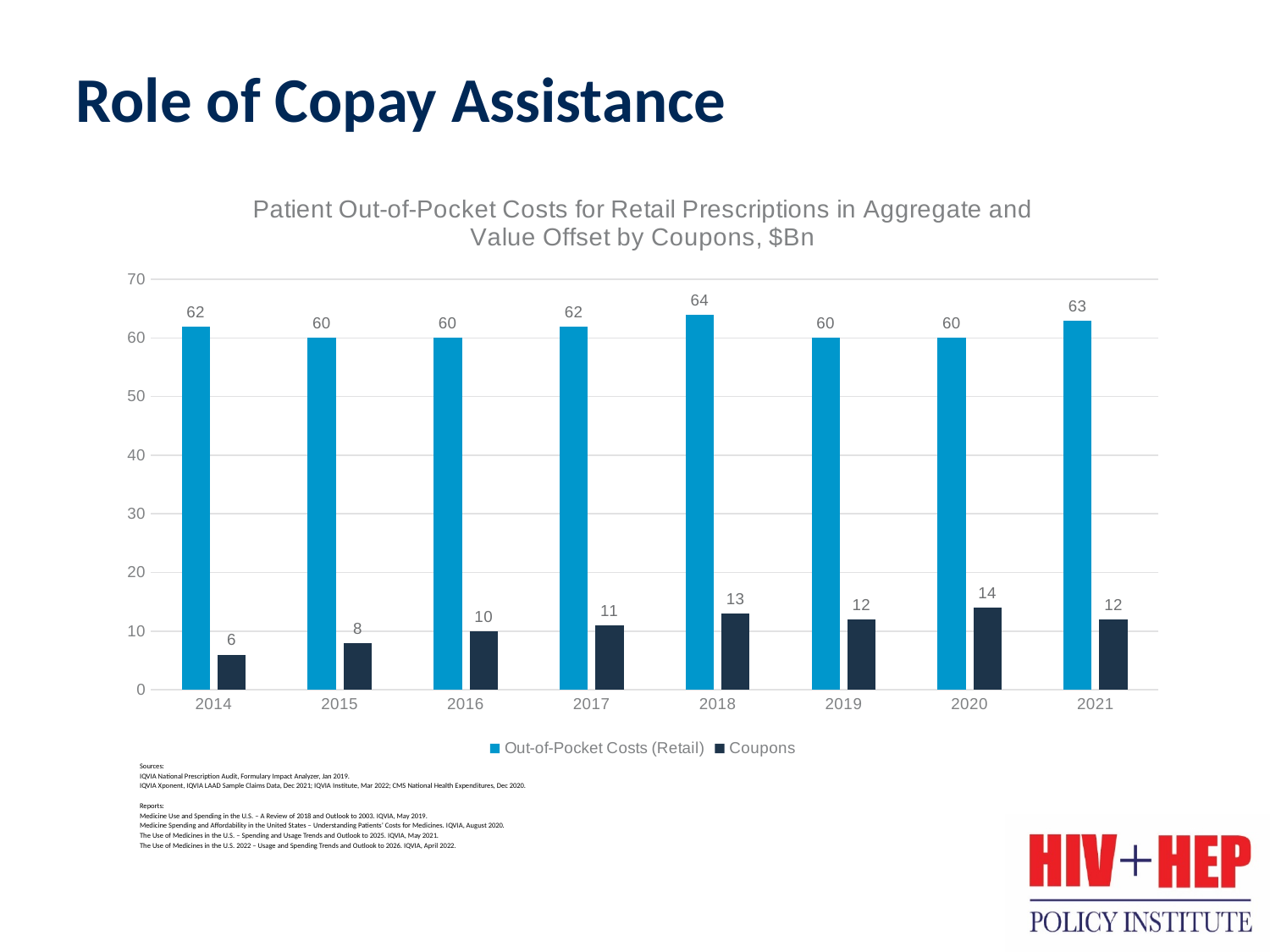
Is the Coupons value for 2016 greater or less than 20? less Which year has the lowest Coupons value? 2014 What kind of chart is shown on the slide? Bar chart Do the Coupons values generally rise or fall from 2014 to 2020? Rise Which is larger, the Coupons value in 2017 or the Coupons value in 2019? 2019 What is the value for Coupons in 2020? 14 Which year has the highest Out-of-Pocket Costs (Retail) value? 2018 How many series does the legend list? 2 What is the difference between the Out-of-Pocket Costs (Retail) value and the Coupons value in 2021? 51 How many years are shown on the x axis? 8 What is the value for Out-of-Pocket Costs (Retail) in 2018? 64 What is the value for Coupons in 2014? 6